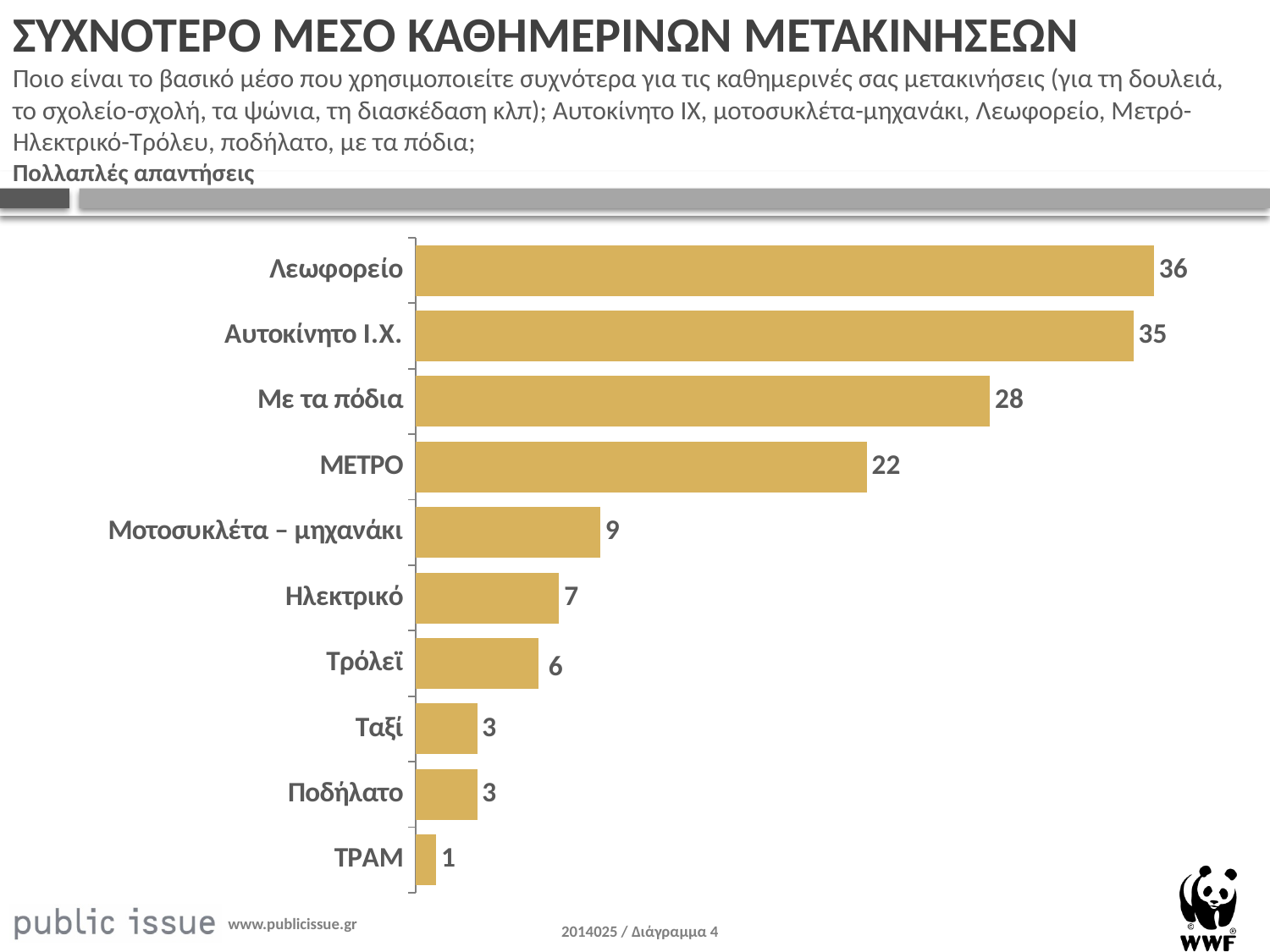
Which is larger, the value for Ηλεκτρικό or the value for Τρόλεϊ? Ηλεκτρικό What is the value for ΜΕΤΡΟ? 22 What is the title of the slide? ΣΥΧΝΟΤΕΡΟ ΜΕΣΟ ΚΑΘΗΜΕΡΙΝΩΝ ΜΕΤΑΚΙΝΗΣΕΩΝ Which category has the lowest value? ΤΡΑΜ What kind of chart is shown on the slide? Bar chart What is the value for Λεωφορείο? 36 What is the difference between the values for ΜΕΤΡΟ and Μοτοσυκλέτα – μηχανάκι? 13 Which category has the highest value? Λεωφορείο Which is larger, the value for Αυτοκίνητο Ι.Χ. or the value for Με τα πόδια? Αυτοκίνητο Ι.Χ. What is the difference between the values for Λεωφορείο and Με τα πόδια? 8 How many categories are shown in the chart? 10 What is the value for Ηλεκτρικό? 7